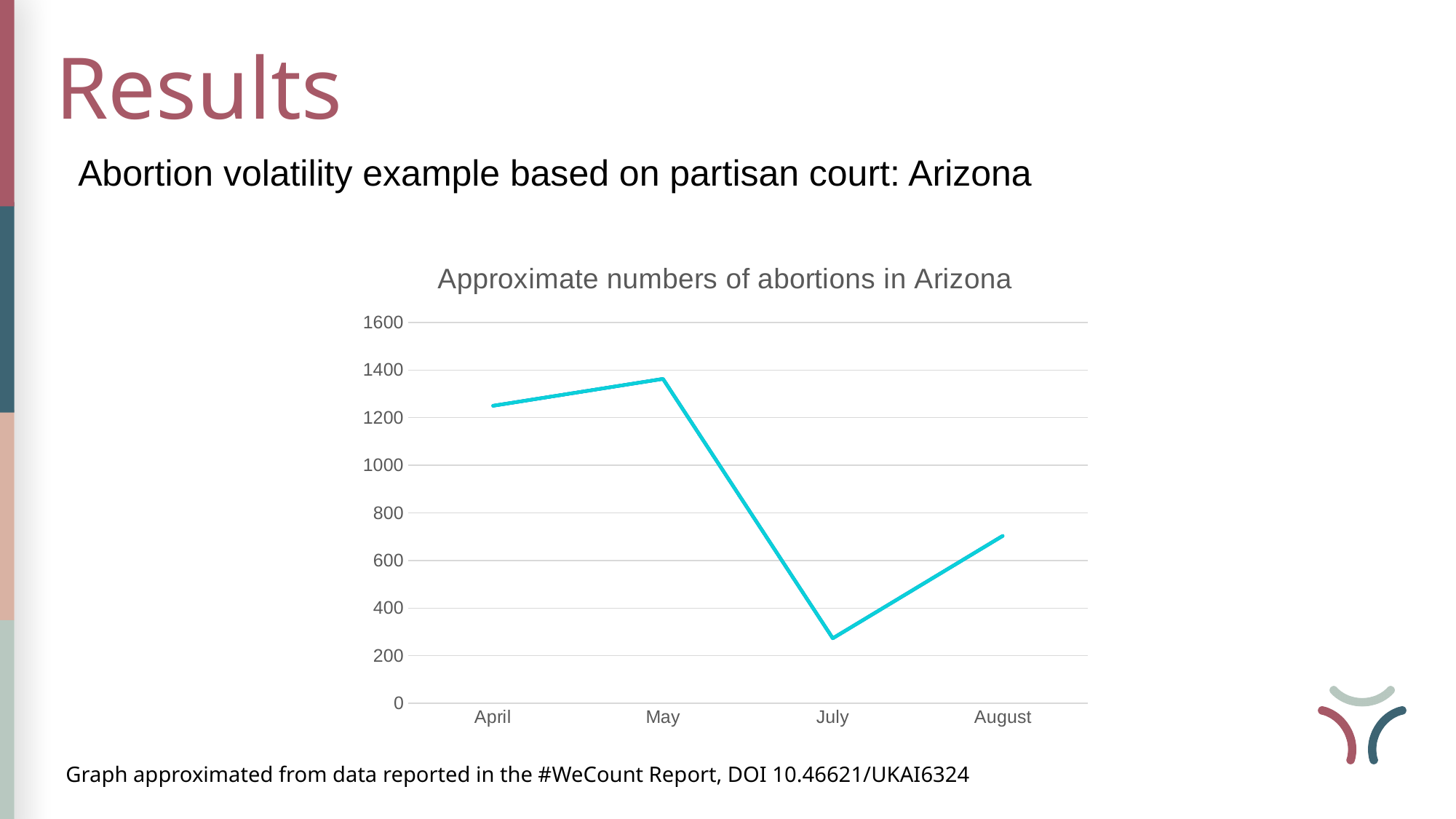
Does the line rise or fall between May and July? Falls Which is larger, the value for April or the value for August? April Is the value for May greater or less than 1200? greater Is the value for July greater or less than 400? less Does the line rise or fall between July and August? Rises How many months are plotted on the x axis of the chart? 4 What kind of chart is shown on the slide? Line chart What is the title of the chart? Approximate numbers of abortions in Arizona Is the value for August greater or less than 600? greater Which month has the highest value in the chart? May Which month has the lowest value in the chart? July